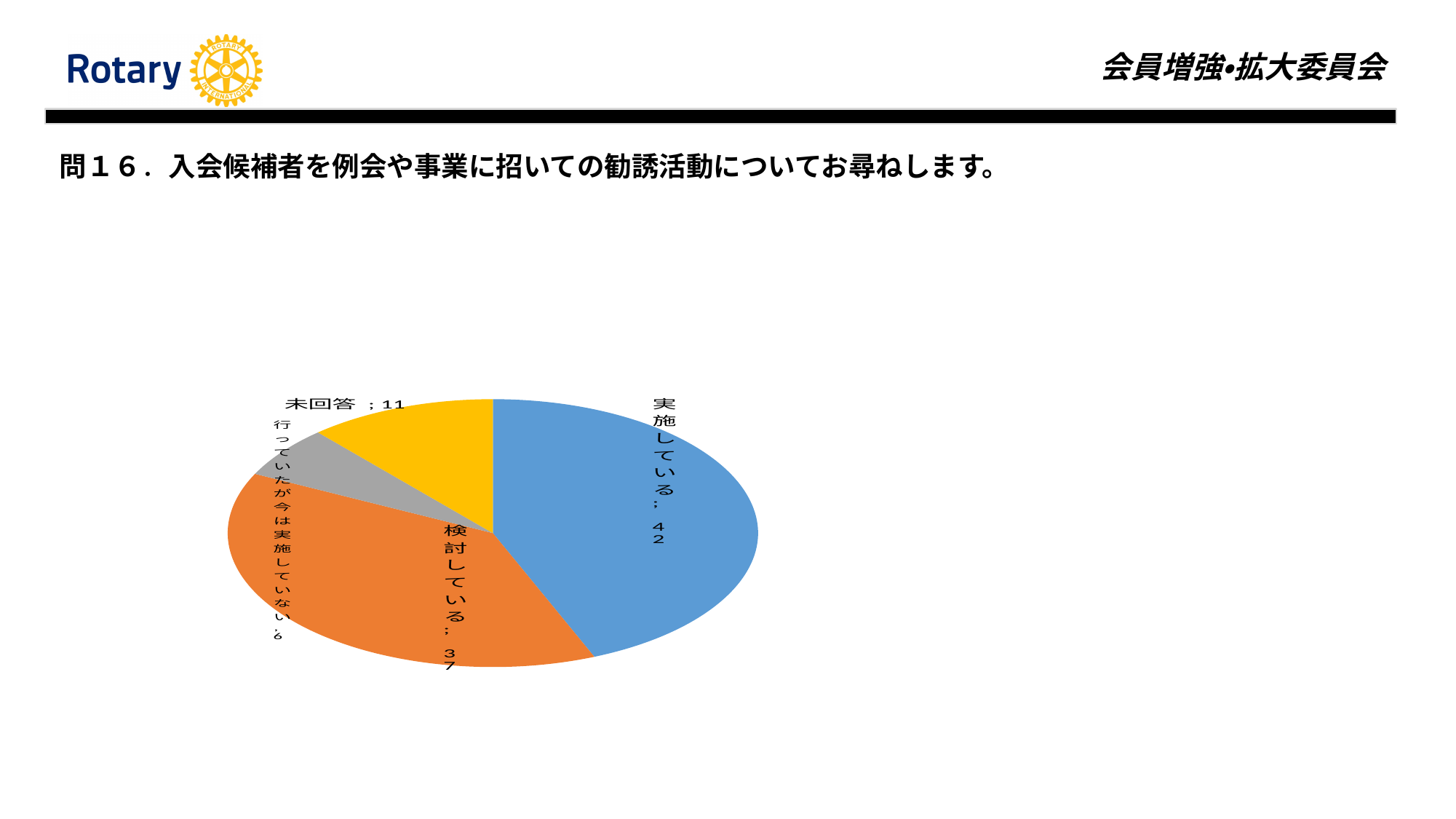
What colour is the slice for 実施している? blue Which category has the largest slice? 実施している What is the difference between the values for 実施している and 検討している? 5 Which is larger, the value for 未回答 or the value for 行っていたが今は実施していない? 未回答 What kind of chart is shown on the slide? pie chart What is the value for 未回答? 11 What is the total of all slices in the pie chart? 96 How many slices does the pie chart have? 4 What is the value for 検討している? 37 What is the value for 行っていたが今は実施していない? 6 What is the value for 実施している? 42 Which category has the smallest slice? 行っていたが今は実施していない